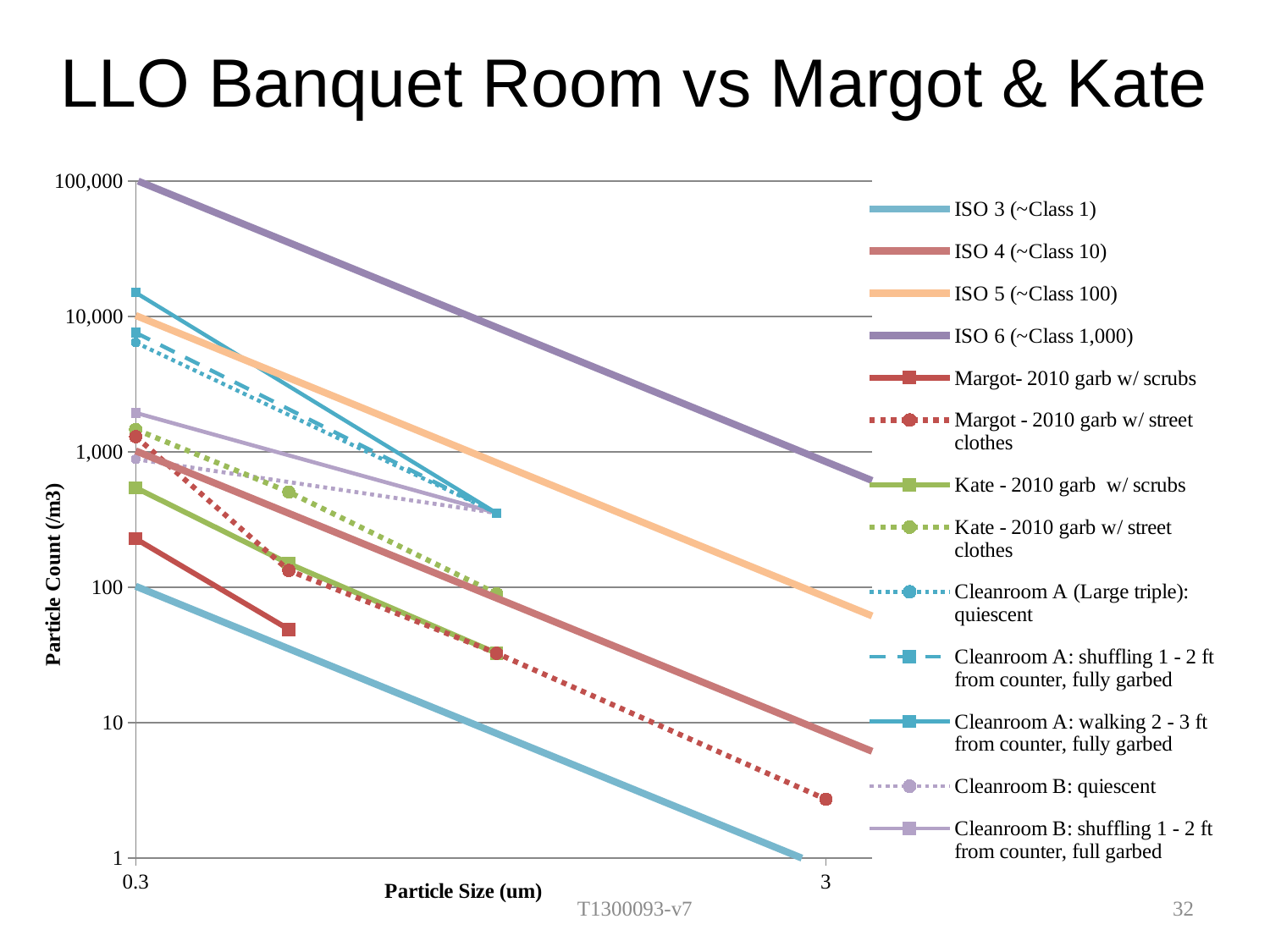
Is the value for Margot- 2010 garb w/ scrubs at 0.3 um greater or less than 100? greater How many series does the legend list? 13 Is the value for Margot - 2010 garb w/ street clothes at 3 um greater or less than 10? less Which series has the lowest particle count at 0.3 um? ISO 3 (~Class 1) What is the label of the vertical axis? Particle Count (/m3) What is the title of the slide's chart? LLO Banquet Room vs Margot & Kate What kind of chart is shown on the slide? line chart Which series has the highest particle count at 0.3 um? ISO 6 (~Class 1,000) Do the plotted lines rise or fall as particle size increases along the x axis? fall At 0.3 um, which is higher: Kate - 2010 garb w/ scrubs or Margot- 2010 garb w/ scrubs? Kate - 2010 garb w/ scrubs Is the value for Cleanroom A: walking 2 - 3 ft from counter, fully garbed at 0.3 um greater or less than 10,000? greater At 0.3 um, which is higher: Cleanroom A: walking 2 - 3 ft from counter, fully garbed or Cleanroom B: shuffling 1 - 2 ft from counter, full garbed? Cleanroom A: walking 2 - 3 ft from counter, fully garbed